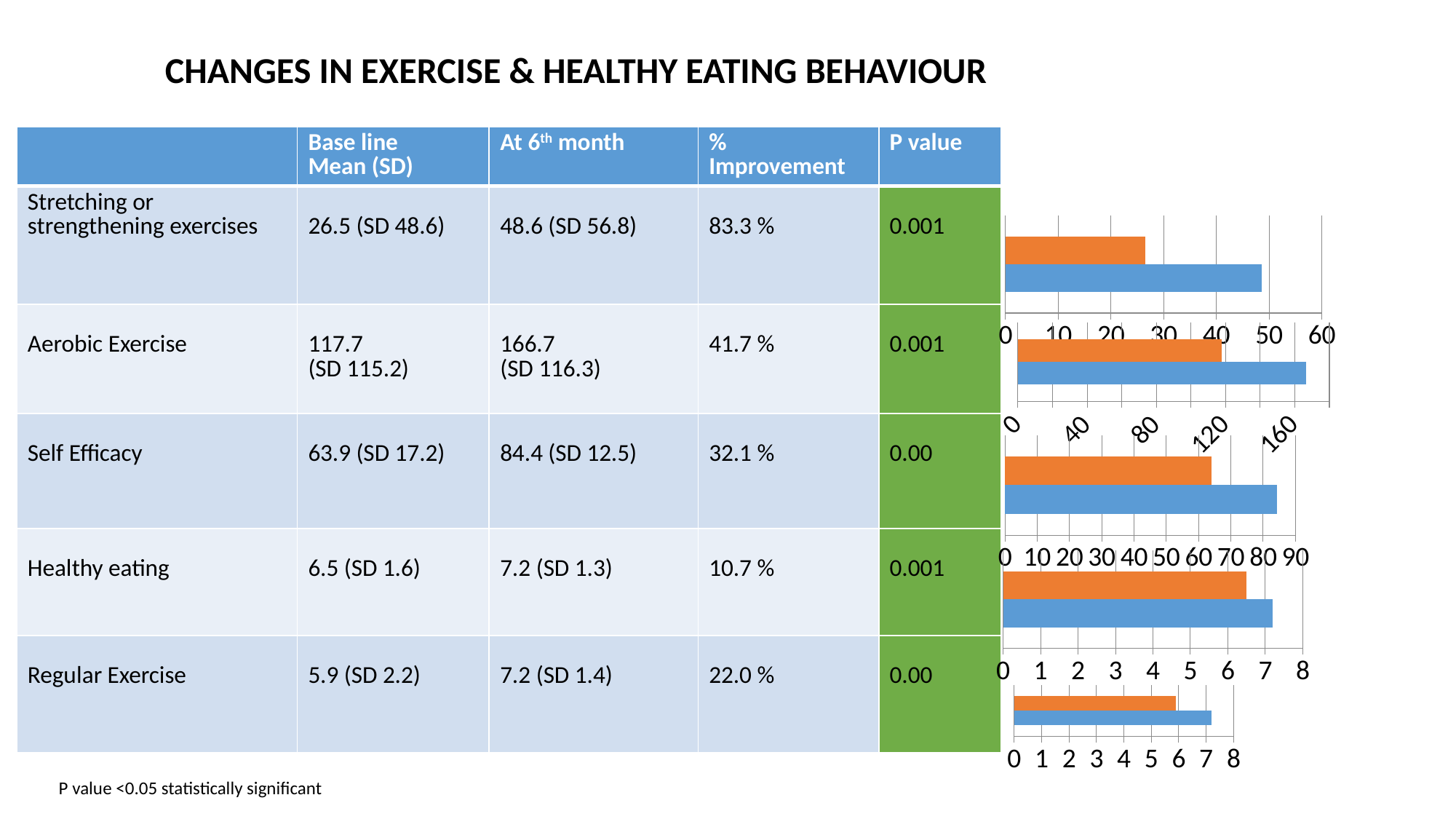
In the topmost chart on the right, is the orange bar greater or less than 30? less What two colours are used for the bars in the charts on the right side of the slide? orange and blue In the topmost chart on the right, which bar is longer, the orange bar or the blue bar? the blue bar In the bottommost chart on the right, is the blue bar greater or less than 6? greater How many separate charts are shown on the right side of the slide? 5 In the topmost chart on the right, is the blue bar greater or less than 40? greater What kind of chart is the topmost chart on the right side of the slide? bar chart How many bars does the topmost chart on the right contain? 2